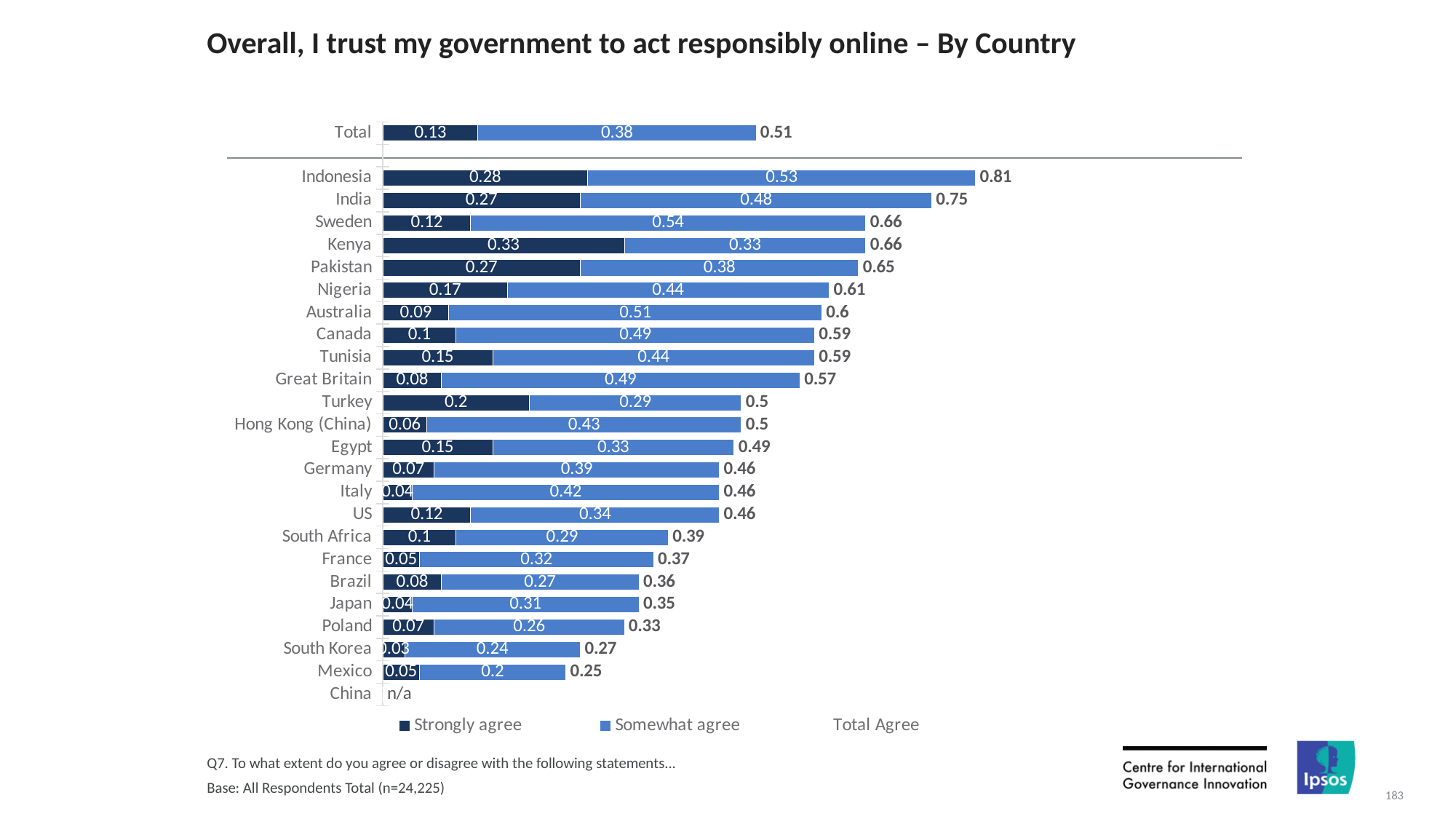
Which country has the highest Strongly agree value? Kenya Among countries with a value shown, which has the lowest Total Agree value? Mexico What is the Total Agree value for the Total row? 0.51 What is the Total Agree value for Indonesia? 0.81 How many series does the legend list? 3 What is the difference between the Total Agree values for Indonesia and India? 0.06 Which country has the highest Total Agree value? Indonesia What is the Strongly agree value for Kenya? 0.33 Which has a larger Somewhat agree value, Australia or Canada? Australia What is the Somewhat agree value for Sweden? 0.54 What is the total of the stacked bar for Pakistan (Strongly agree plus Somewhat agree)? 0.65 What kind of chart is shown on the slide? Stacked bar chart